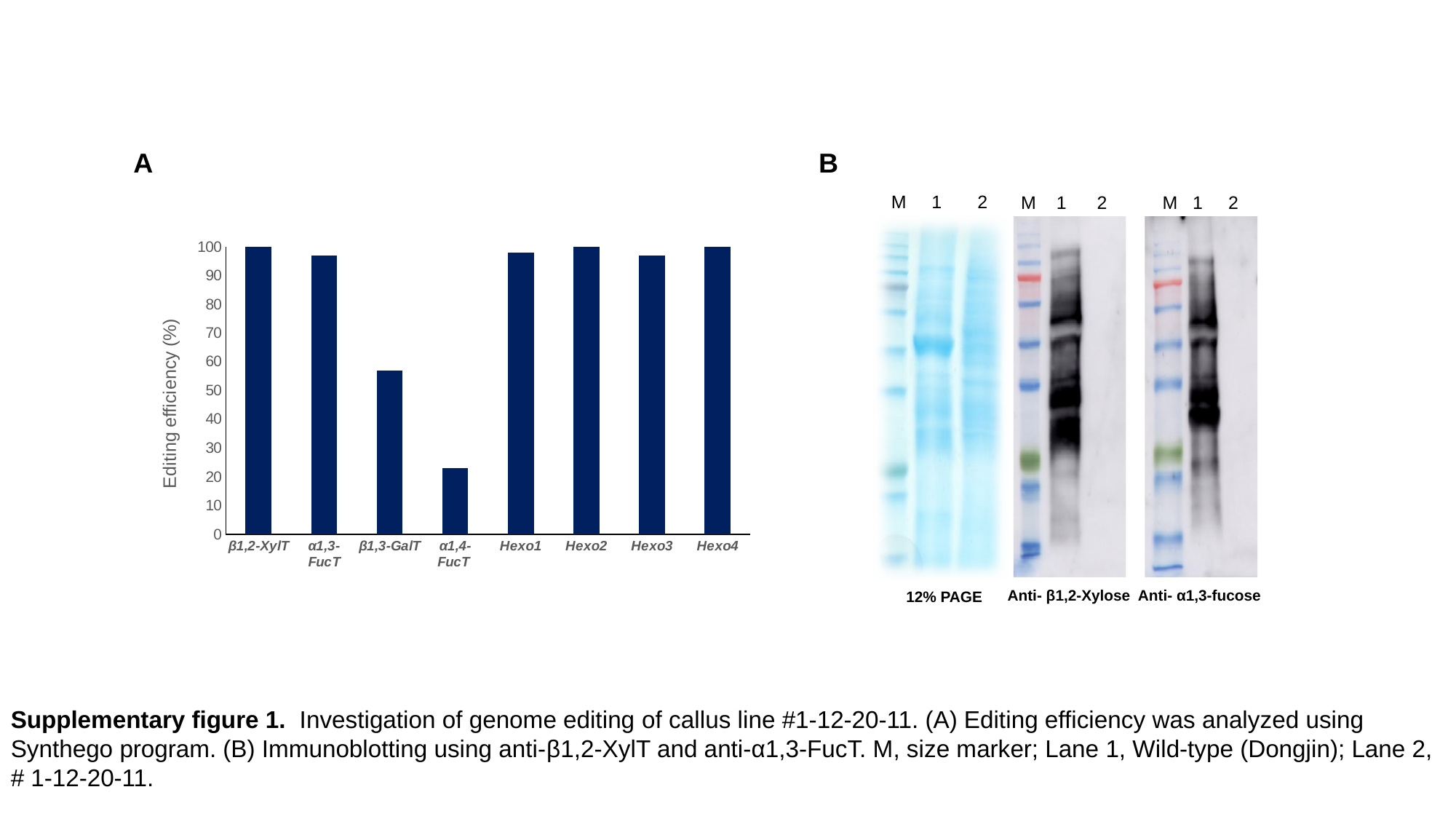
What is the y-axis label of the bar chart in panel A? Editing efficiency (%) What is the maximum value shown on the y axis of the bar chart in panel A? 100 In the bar chart in panel A, which category has the lowest editing efficiency? α1,4-FucT In the bar chart in panel A, is the value for α1,3-FucT greater or less than 90? greater In the bar chart in panel A, which is larger, the value for Hexo1 or the value for β1,3-GalT? Hexo1 How many categories are plotted on the x axis of the bar chart in panel A? 8 In the bar chart in panel A, is the value for Hexo3 greater or less than 80? greater What kind of chart is shown in panel A? bar chart In the bar chart in panel A, which is larger, the value for β1,3-GalT or the value for α1,4-FucT? β1,3-GalT In the bar chart in panel A, is the value for β1,3-GalT greater or less than 50? greater